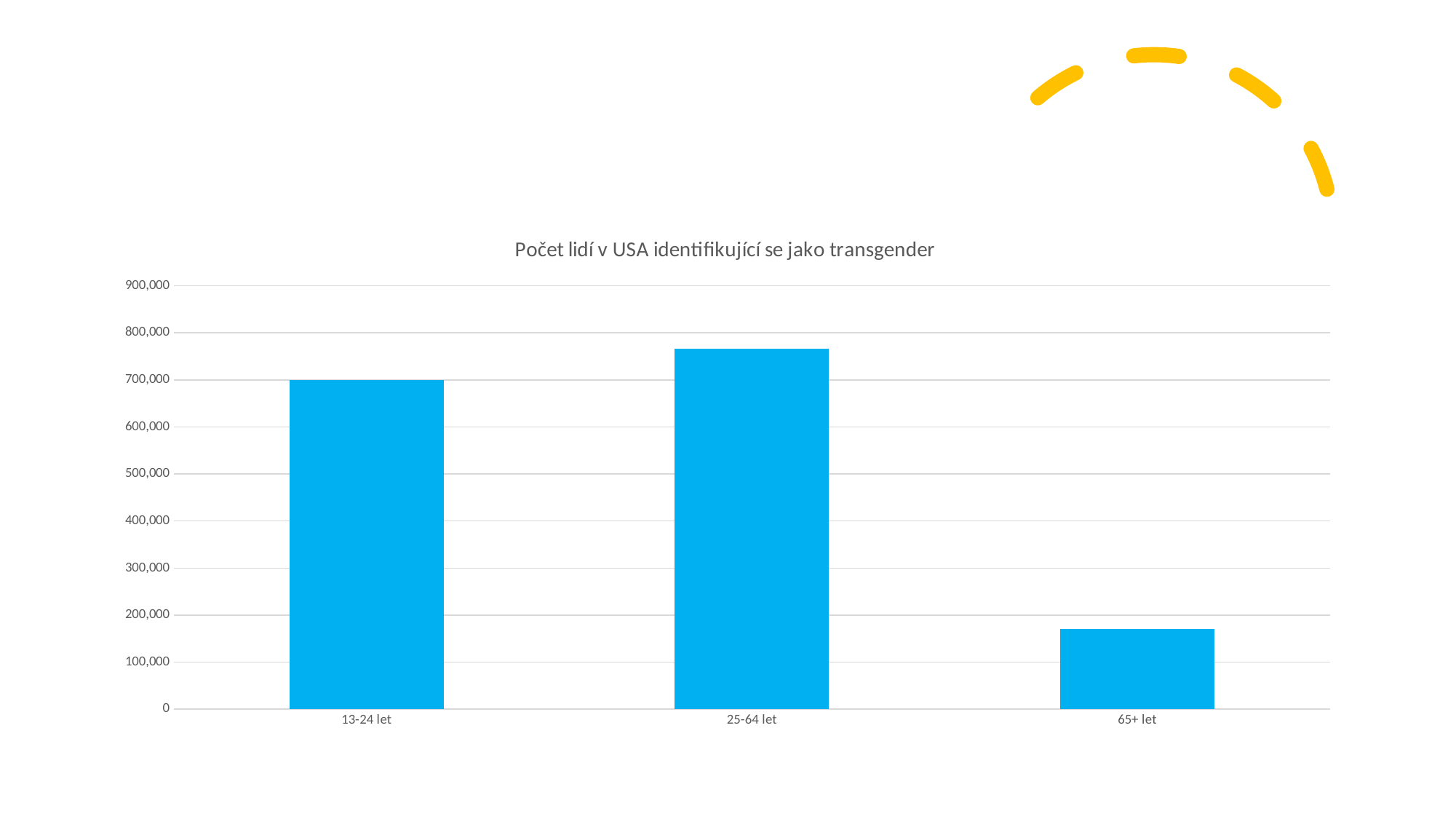
How many age categories are shown on the x axis? 3 What is the title of the chart? Počet lidí v USA identifikující se jako transgender Which age category has the highest value? 25-64 let Is the value for 65+ let greater or less than 200,000? less Is the value for 25-64 let greater or less than 700,000? greater Is the value for 25-64 let greater or less than 800,000? less Which age category has the lowest value? 65+ let What kind of chart is shown on the slide? bar chart What is the highest value shown on the vertical axis? 900,000 Which is larger, the value for 13-24 let or the value for 65+ let? 13-24 let